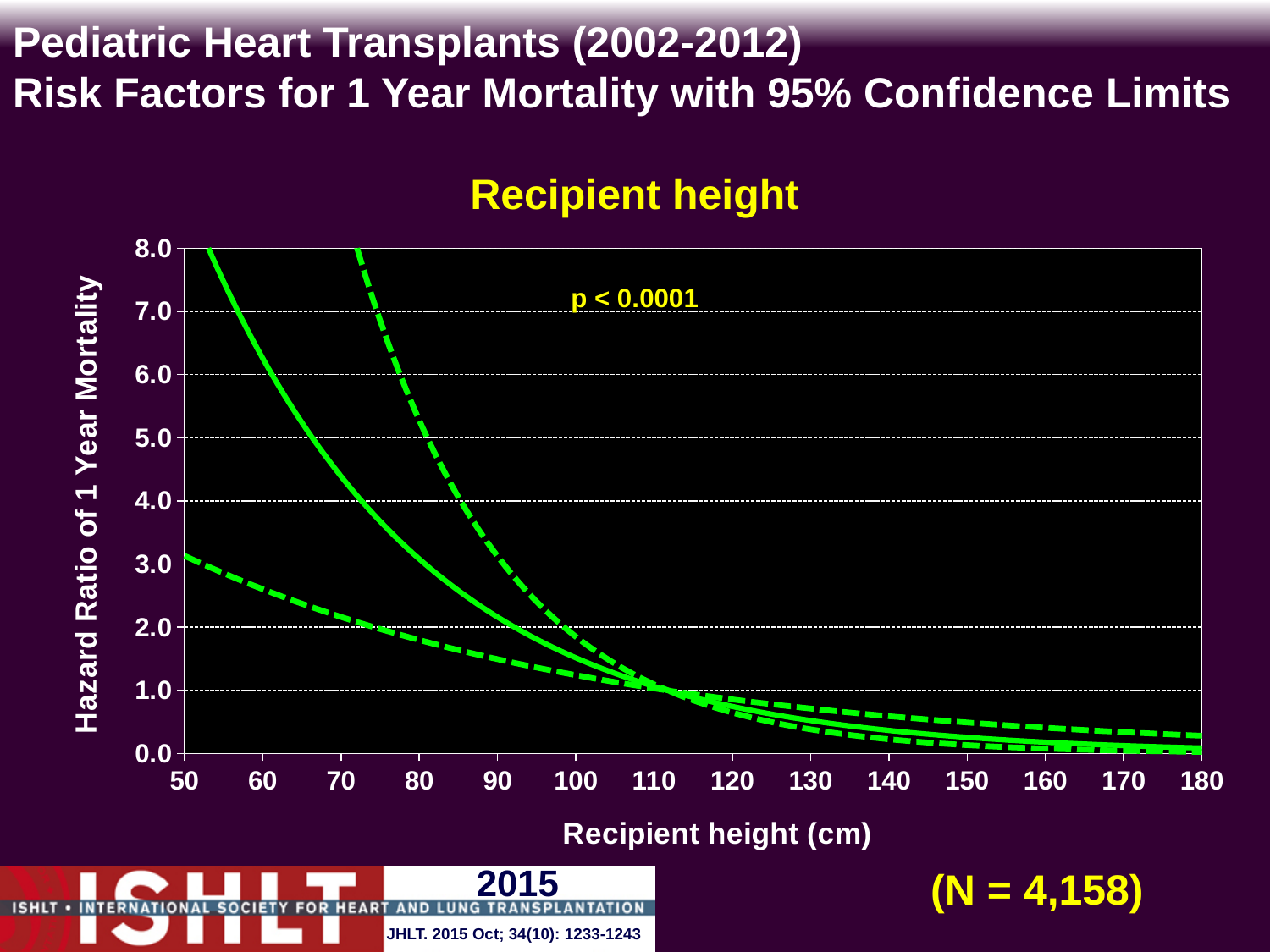
What p-value is printed on the chart? p < 0.0001 How many tick labels are shown on the x axis? 14 What is the highest value shown on the y axis? 8.0 Is the value of the solid line at a recipient height of 60 cm greater or less than 4.0? greater Is the value of the solid line at a recipient height of 150 cm greater or less than 1.0? less How many lines are plotted on the chart? 3 Is the value of the solid line at a recipient height of 80 cm greater or less than 2.0? greater Does the hazard ratio of 1 year mortality rise or fall as recipient height increases? fall What kind of chart is shown on the slide? line chart